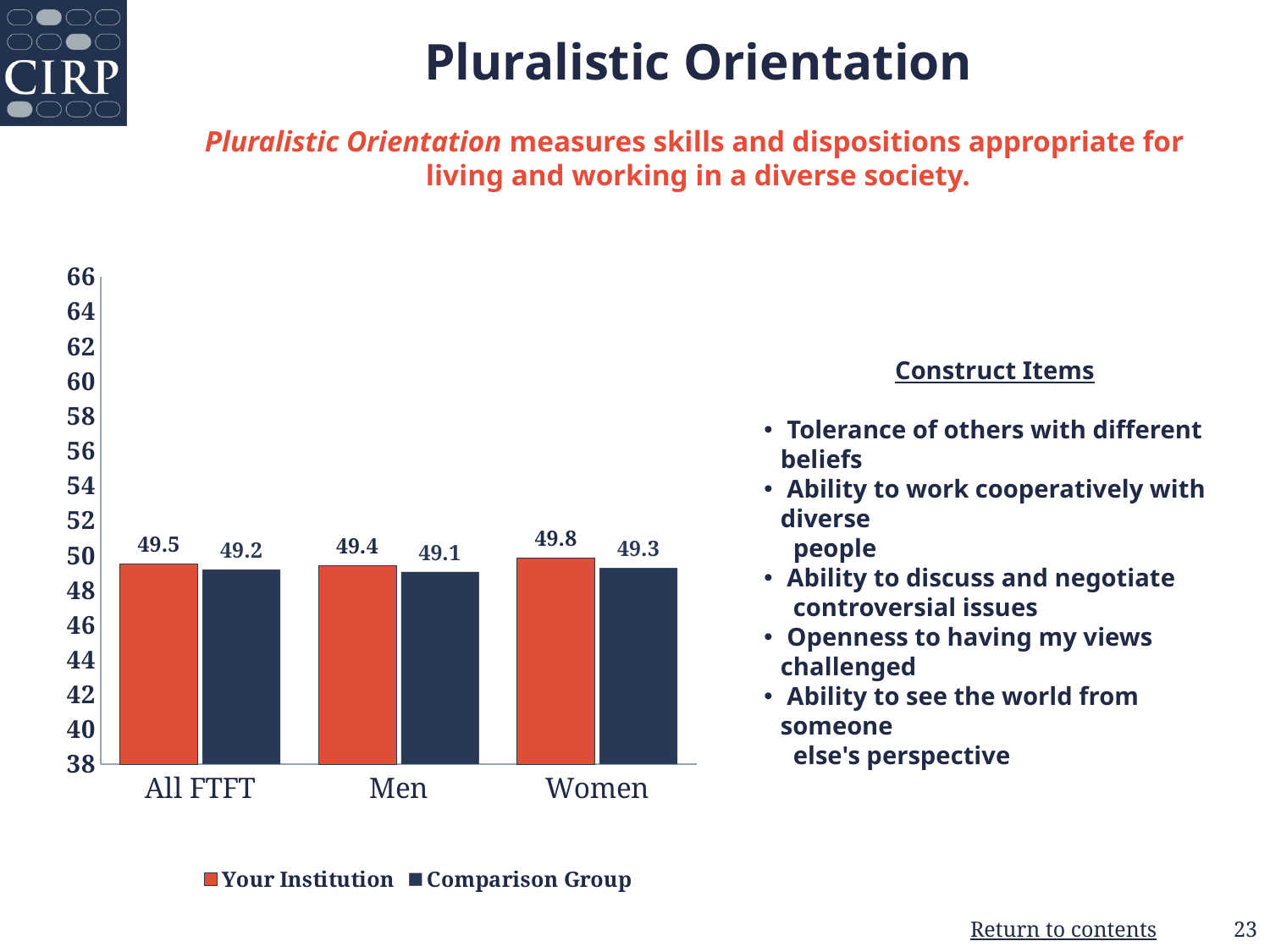
Which is larger in the All FTFT category, Your Institution or Comparison Group? Your Institution What is the value for Your Institution in the All FTFT category? 49.5 Which category has the lowest value for Comparison Group? Men Which category has the highest value for Your Institution? Women How many series does the legend list? 2 What is the difference between Your Institution and Comparison Group in the Men category? 0.3 What is the value for Your Institution in the Women category? 49.8 What kind of chart is shown on the slide? Bar chart What is the value for Comparison Group in the Women category? 49.3 What is the difference between Your Institution and Comparison Group in the Women category? 0.5 What is the value for Comparison Group in the Men category? 49.1 How many categories are shown on the x axis? 3